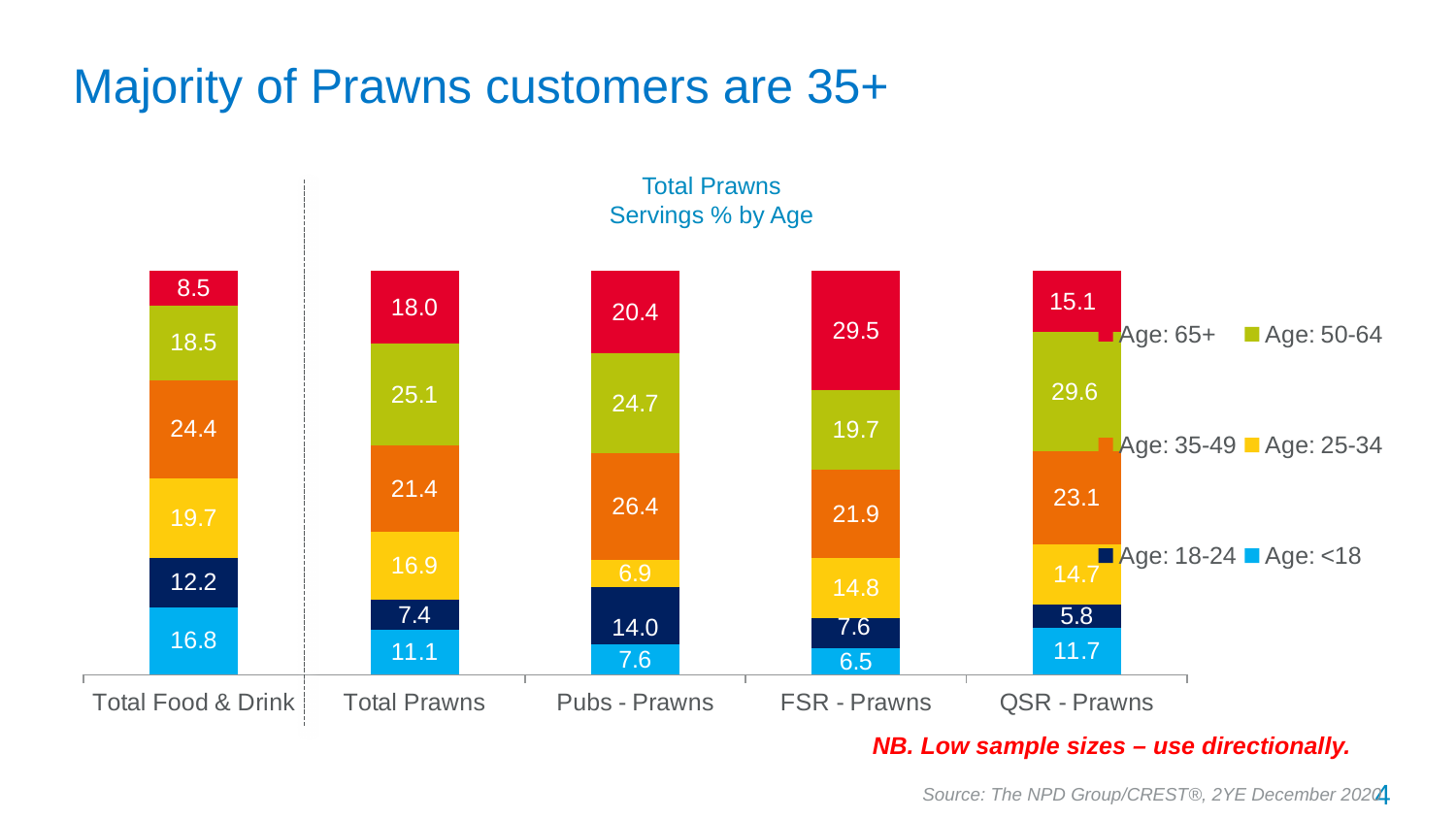
What is the Age: 18-24 value for Pubs - Prawns? 14.0 What is the title of the chart? Total Prawns Servings % by Age What is the Age: 65+ value for FSR - Prawns? 29.5 How many categories are shown on the x axis? 5 How many series does the legend list? 6 What is the Age: 50-64 value for QSR - Prawns? 29.6 What is the difference between the Age: 65+ values for FSR - Prawns and Total Food & Drink? 21.0 What is the Age: <18 value for Total Food & Drink? 16.8 What kind of chart is shown on the slide? Stacked bar chart Which category has the highest Age: 65+ value? FSR - Prawns Which category has the lowest Age: <18 value? FSR - Prawns Which is larger, the Age: 35-49 value for Pubs - Prawns or for QSR - Prawns? Pubs - Prawns